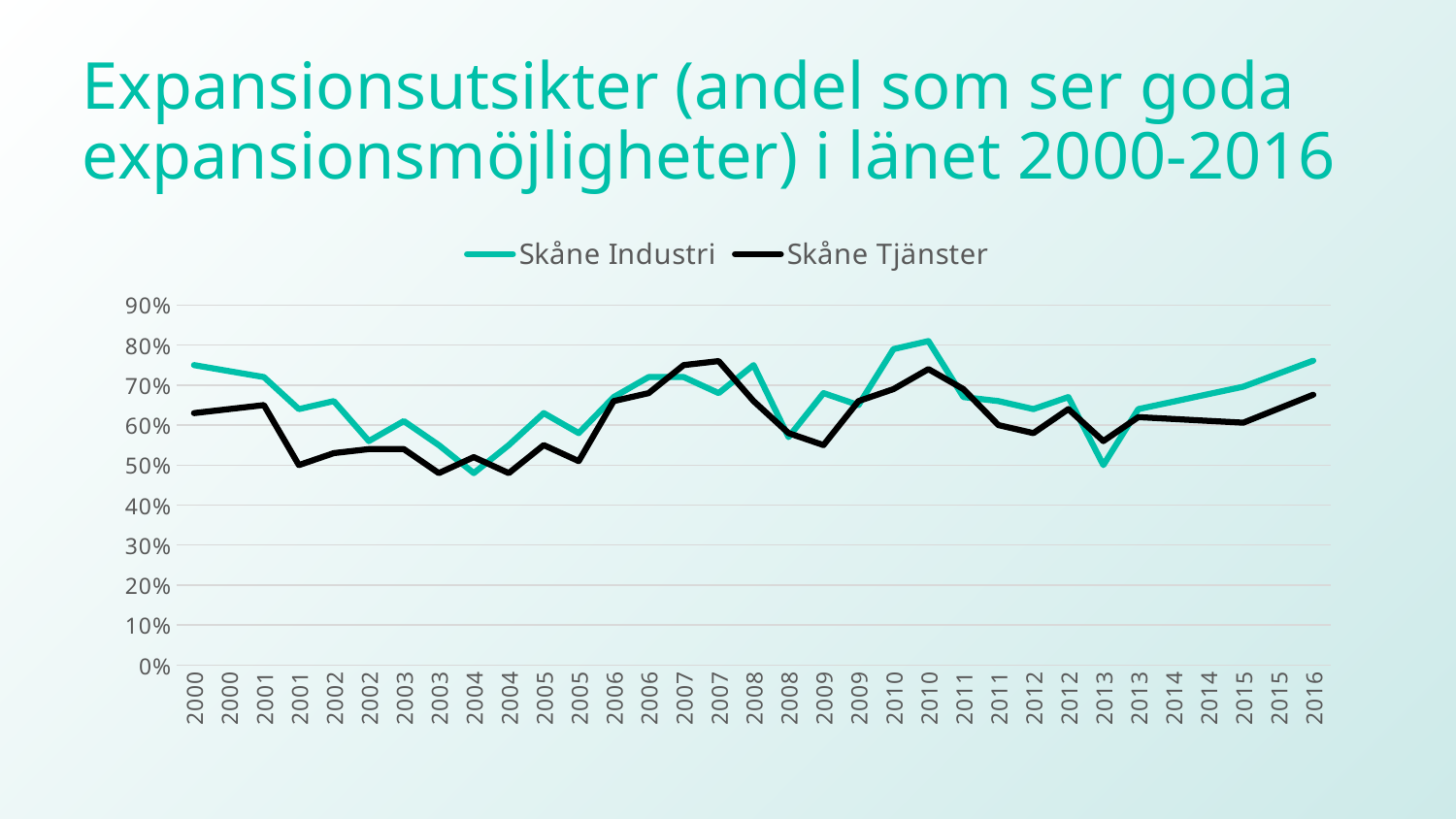
What is the last year shown on the x axis? 2016 At which year does Skåne Industri reach its highest value? 2010 Is the value for Skåne Tjänster at the second 2003 point greater or less than 50%? less How many series does the legend list? 2 Is the value for Skåne Industri at the first 2000 point greater or less than 70%? greater Is the value for Skåne Tjänster at 2016 greater or less than 70%? less At the first 2000 point, which series has the higher value, Skåne Industri or Skåne Tjänster? Skåne Industri Does the Skåne Industri line rise or fall from 2013 to 2016? rise Which series is drawn in black? Skåne Tjänster What kind of chart is shown on the slide? line chart